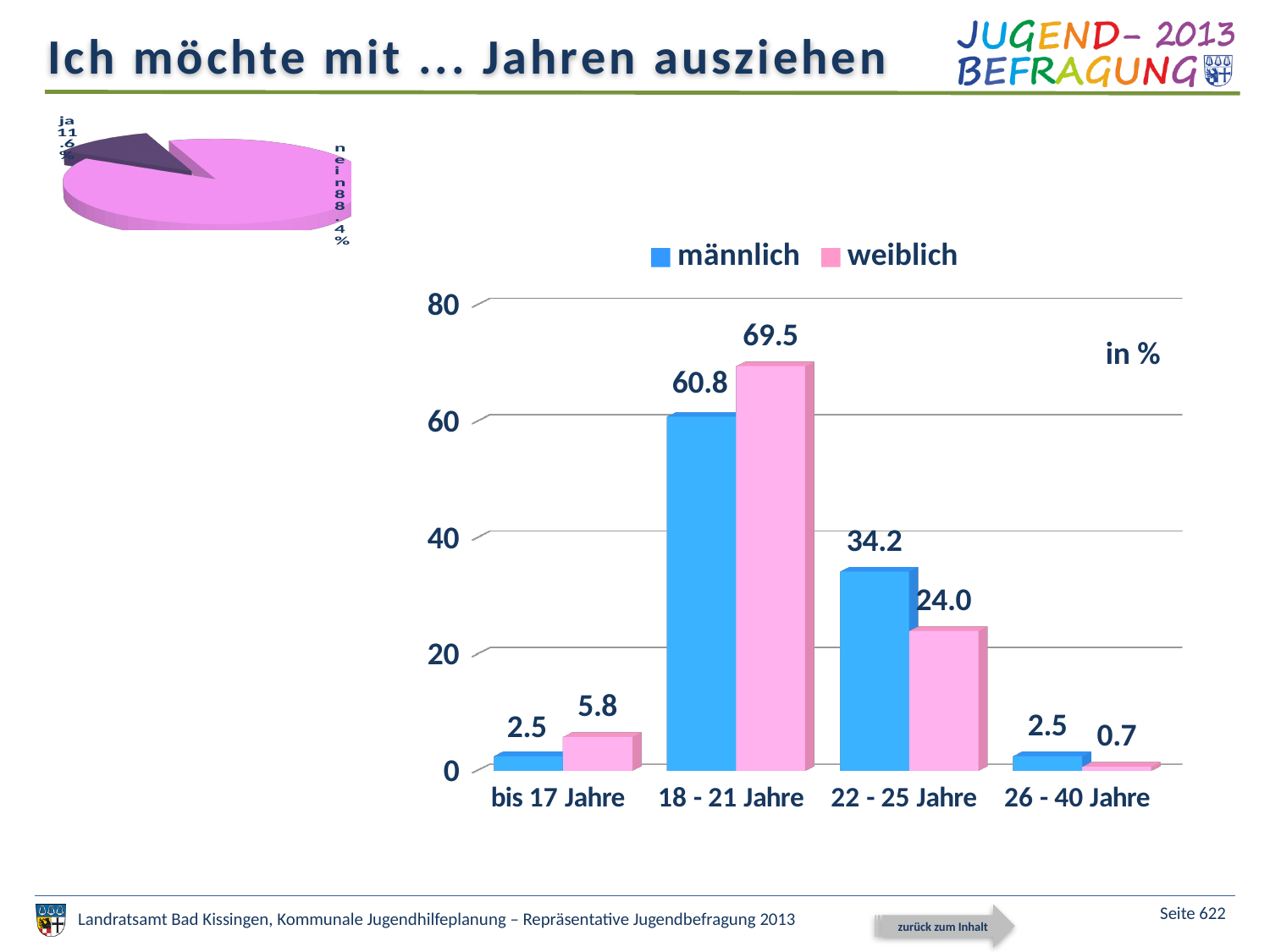
In the bar chart, how many series does the legend list? 2 In the bar chart, how many age categories are shown on the x axis? 4 In the pie chart at the top left, what share is labelled 'ja'? 11.6% In the bar chart, what is the value for männlich in the 22 - 25 Jahre category? 34.2 In the bar chart, which is larger in the 22 - 25 Jahre category, männlich or weiblich? männlich In the bar chart, what is the value for weiblich in the 18 - 21 Jahre category? 69.5 In the bar chart, what is the value for weiblich in the 26 - 40 Jahre category? 0.7 In the bar chart, which age category has the lowest value for weiblich? 26 - 40 Jahre What kind of chart is the large chart on the right of the slide? bar chart In the pie chart at the top left, what share is labelled 'nein'? 88.4% In the bar chart, which age category has the highest value for männlich? 18 - 21 Jahre In the bar chart, what is the difference between weiblich and männlich in the 18 - 21 Jahre category? 8.7